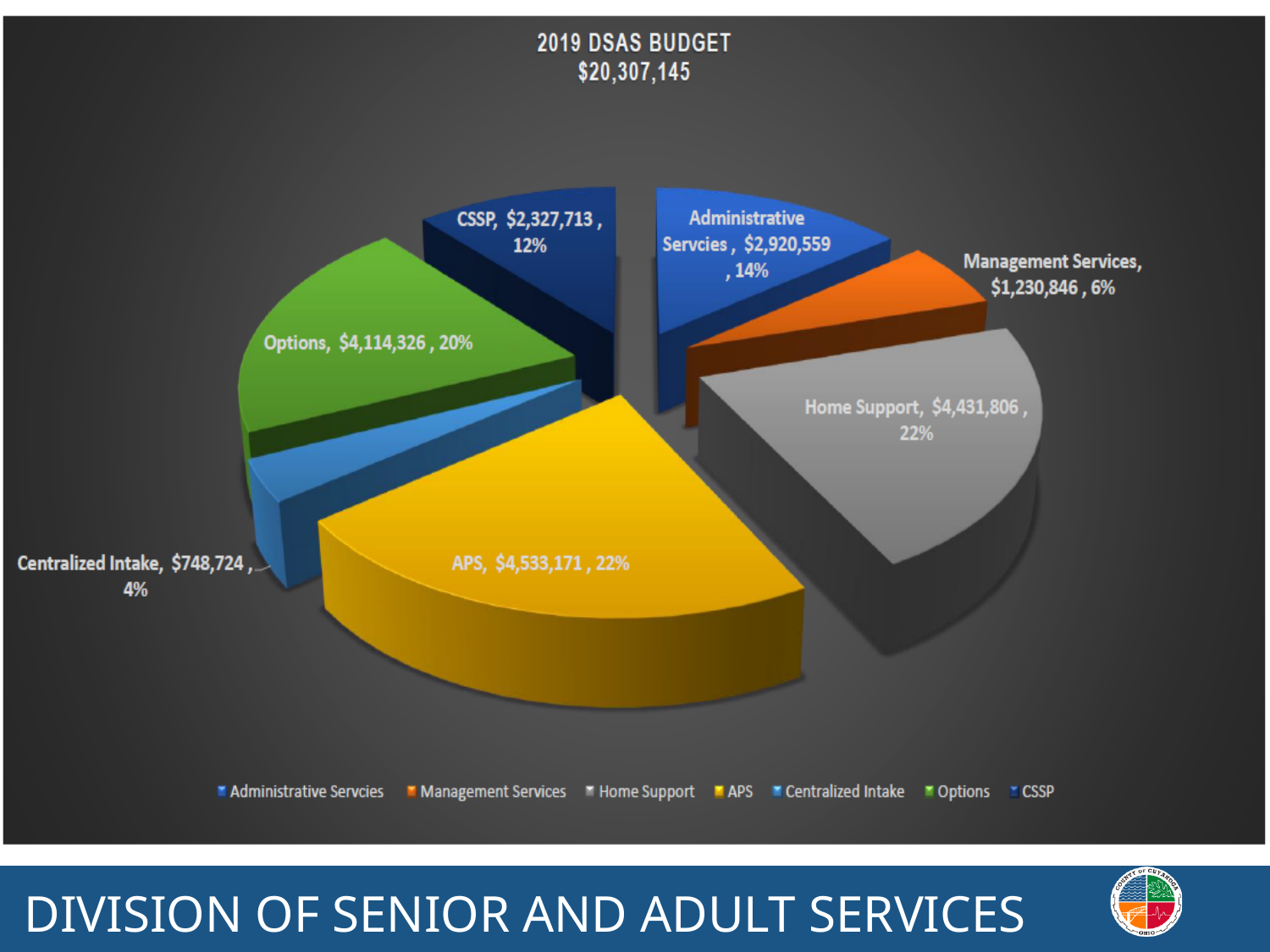
What total budget amount is shown in the chart title? $20,307,145 Which is larger, the budget for Administrative Services or the budget for Management Services? Administrative Services What share of the pie does Options represent? 20% What is the budget amount for Centralized Intake? $748,724 What is the budget amount for Home Support? $4,431,806 What is the difference between the APS budget and the Home Support budget? $101,365 What is the difference between the Options budget and the CSSP budget? $1,786,613 How many categories are shown in the pie chart? 7 What kind of chart is shown on the slide? Pie chart Which category has the largest budget amount? APS What is the budget amount for CSSP? $2,327,713 Which category has the smallest budget amount? Centralized Intake